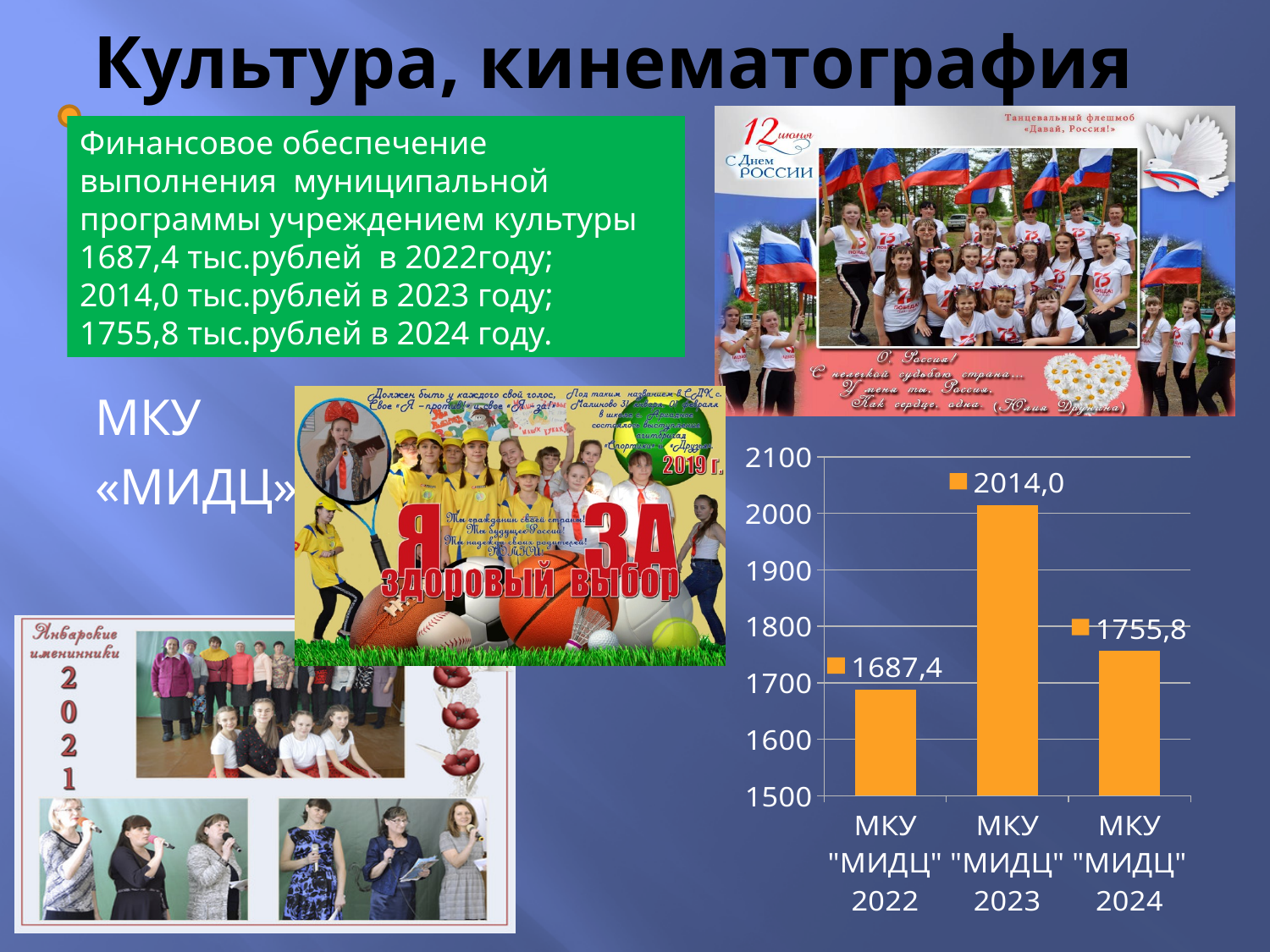
What type of chart is shown on the slide? bar chart What is the value for МКУ "МИДЦ" 2023 in the bar chart? 2014,0 How many bars are shown in the bar chart? 3 What is the value for МКУ "МИДЦ" 2024 in the bar chart? 1755,8 What colour are the bars in the chart? orange Which is larger in the bar chart, the value for 2024 or the value for 2022? 2024 What is the value for МКУ "МИДЦ" 2022 in the bar chart? 1687,4 Which year has the highest value in the bar chart? 2023 What is the difference between the values for 2023 and 2022 in the bar chart? 326,6 Which year has the lowest value in the bar chart? 2022 Is the value for МКУ "МИДЦ" 2023 greater or less than 2000? greater What is the difference between the values for 2023 and 2024 in the bar chart? 258,2